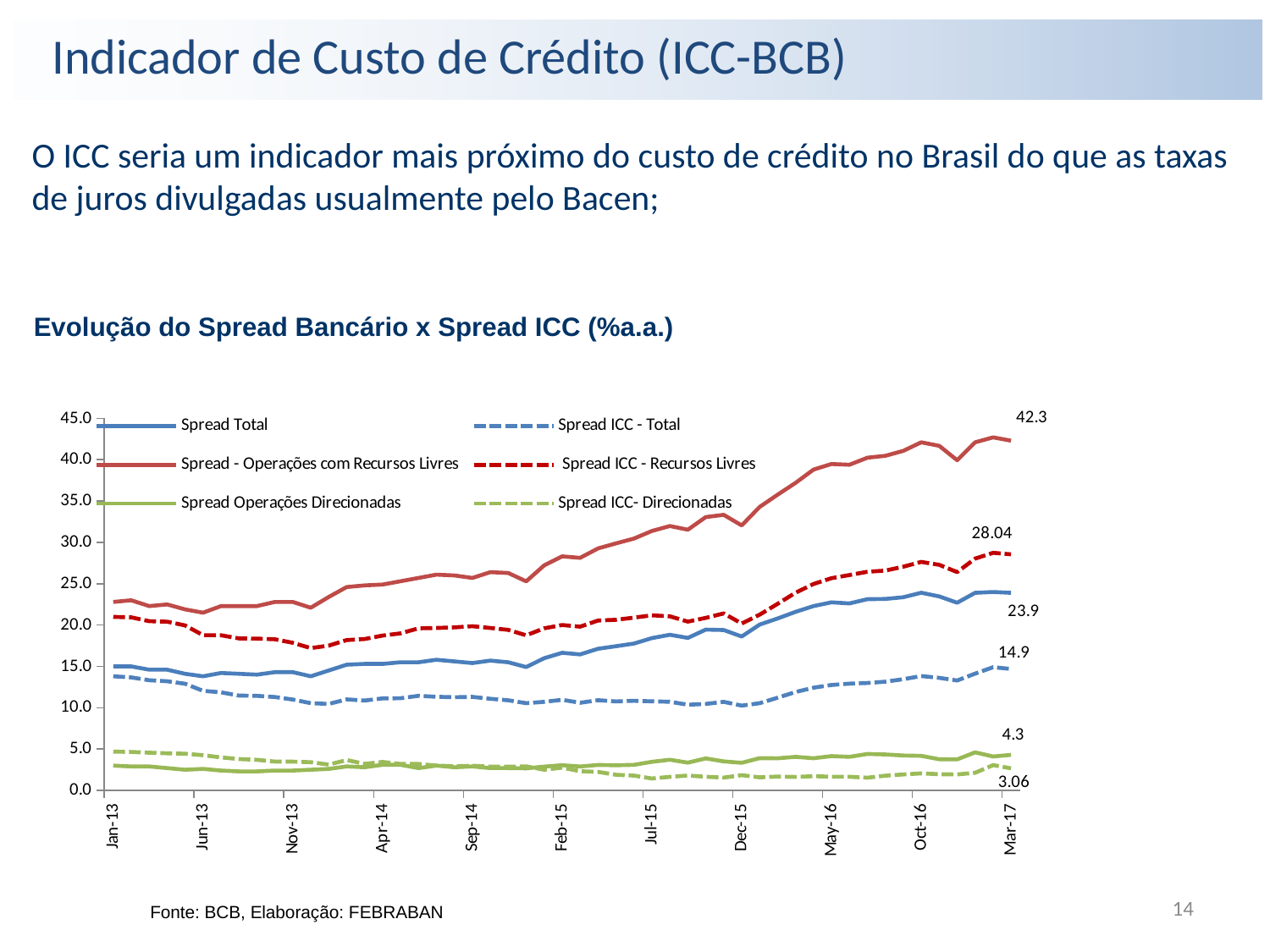
What is the difference between the Mar-17 values of 'Spread Total' (23.9) and 'Spread ICC - Total' (14.9)? 9.0 Which series has the lowest value in Mar-17? Spread ICC- Direcionadas What is the title of the chart? Evolução do Spread Bancário x Spread ICC (%a.a.) How many series does the legend list? 6 What is the value labelled at the end of the 'Spread ICC- Direcionadas' line in Mar-17? 3.06 What is the value labelled at the end of the 'Spread - Operações com Recursos Livres' line in Mar-17? 42.3 Does the 'Spread - Operações com Recursos Livres' line generally rise or fall from Jan-13 to Mar-17? rise What is the value labelled at the end of the 'Spread Total' line in Mar-17? 23.9 What is the value labelled at the end of the 'Spread ICC - Recursos Livres' line in Mar-17? 28.04 What is the value labelled at the end of the 'Spread ICC - Total' line in Mar-17? 14.9 What type of chart is shown on the slide? line chart Which series has the highest value in Mar-17? Spread - Operações com Recursos Livres